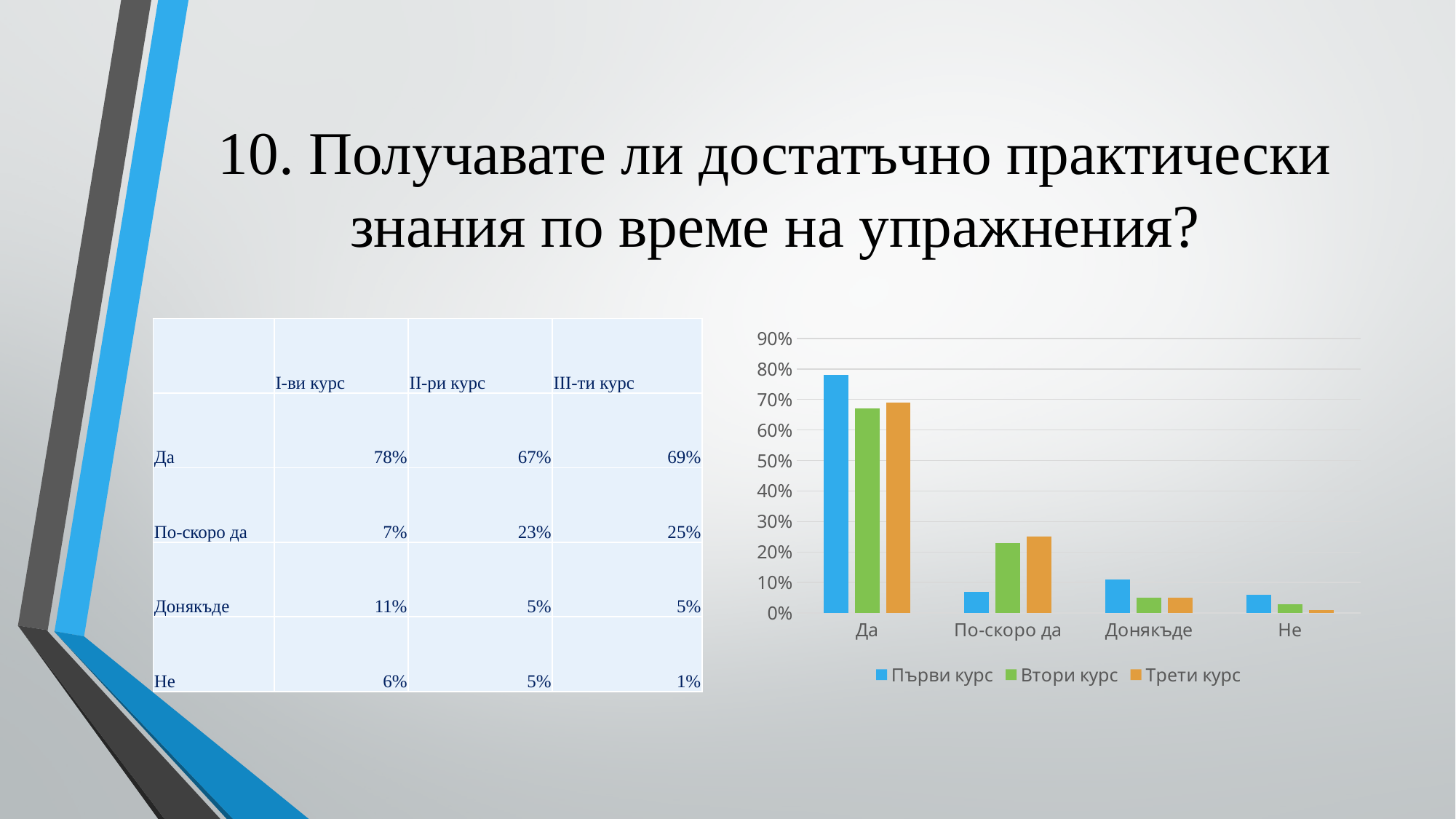
How many categories are shown on the x axis of the chart? 4 How many series does the chart legend list? 3 For the category "По-скоро да", which series is larger: Първи курс or Втори курс? Втори курс What is the difference between the "Да" values for I-ви курс and II-ри курс? 11% What kind of chart is shown on the slide? bar chart Is the value for "Да" in the Втори курс series greater or less than 60%? greater According to the table, what is the value for "Не" for II-ри курс? 5% According to the table, what is the value for "По-скоро да" for III-ти курс? 25% Which series is shown in orange in the chart? Трети курс According to the table, what is the value for "Да" for I-ви курс? 78% Which category has the highest value for the "Първи курс" series? Да Which category has the lowest value for the "Трети курс" series? Не